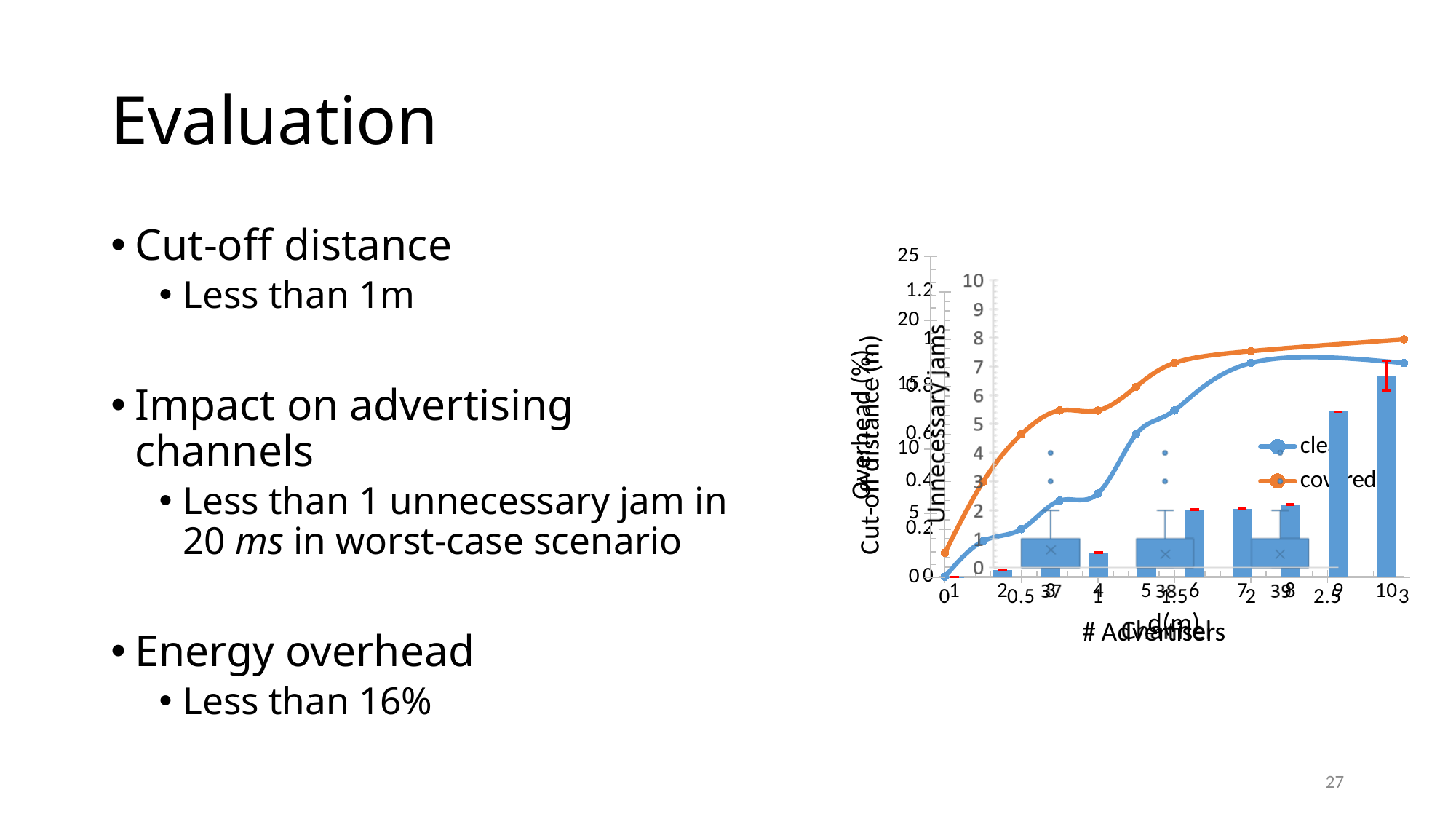
In the bar chart with # Advertisers on the x axis, which number of advertisers has the highest overhead? 10 In the line chart plotted against d(m), do the values of the covered series rise or fall as d(m) increases? rise In the bar chart with # Advertisers on the x axis, which number of advertisers has the lowest overhead? 1 In the line chart plotted against d(m), what are the two legend entries? clear and covered In the bar chart with # Advertisers on the x axis, is the overhead for 9 advertisers greater or less than 10? greater In the chart with # Advertisers on the x axis, what kind of chart is used to show Overhead (%)? bar chart In the line chart plotted against d(m), what is the label of the x axis? d(m) In the bar chart with # Advertisers on the x axis, is the overhead for 2 advertisers greater or less than 5? less In the bar chart with # Advertisers on the x axis, does the overhead generally rise or fall as the number of advertisers increases? rise In the line chart plotted against d(m), how many series does the legend list? 2 In the bar chart with # Advertisers on the x axis, how many advertiser categories are shown? 10 In the line chart plotted against d(m), which series has the higher values across the x axis, clear or covered? covered